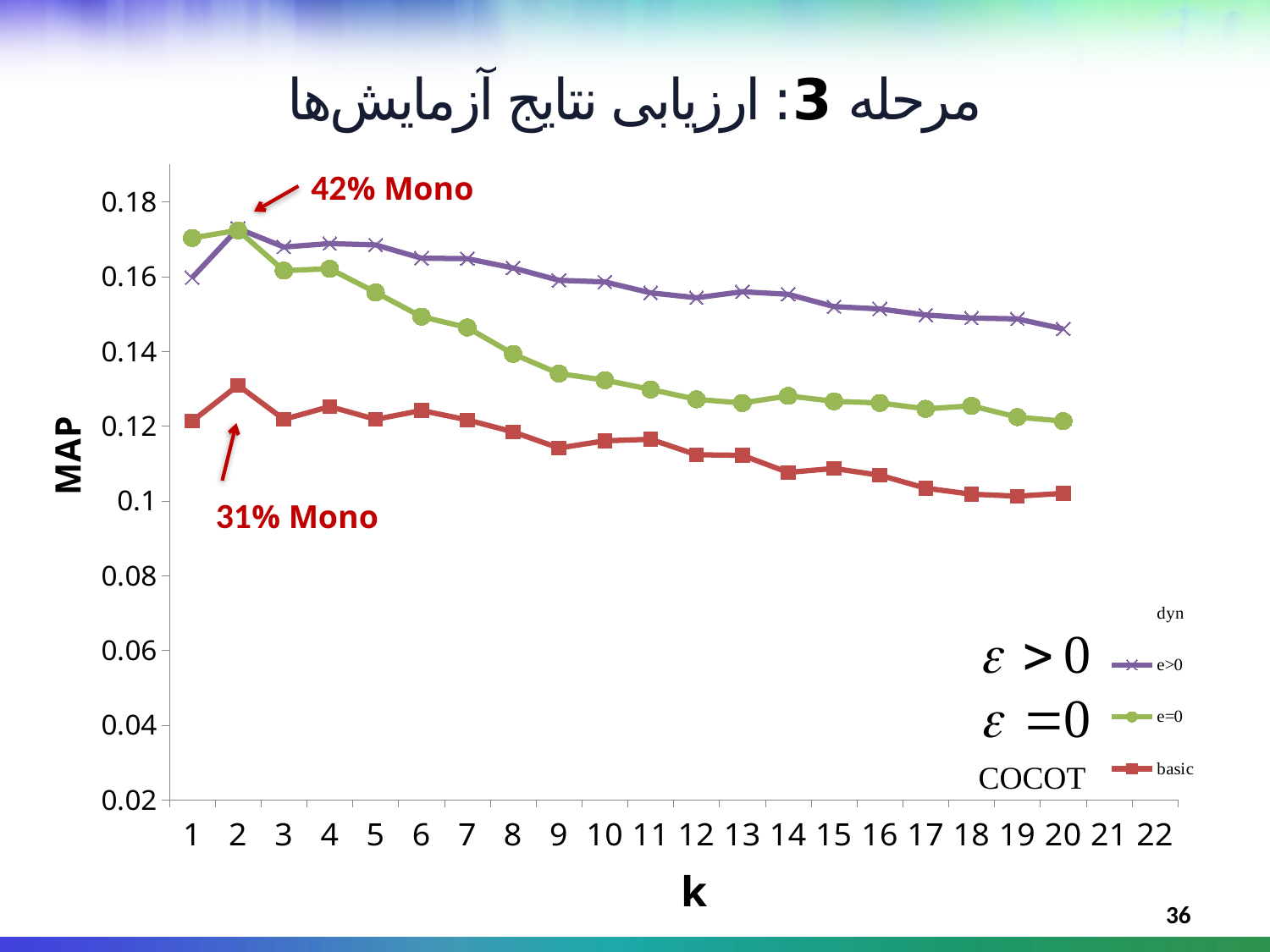
Is the value of the e>0 series at k=20 greater or less than 0.14? greater What annotation is attached to the peak of the e>0 series at k=2? 42% Mono Is the value of the e=0 series at k=1 greater or less than 0.16? greater Does the basic series generally rise or fall as k increases from 1 to 20? fall How many series does the legend list? 4 Is the value of the basic series at k=20 greater or less than 0.12? less What kind of chart is shown on the slide? line chart Does the e=0 series rise or fall as k increases from 2 to 20? fall Which series has the highest MAP value at k=15? e>0 At k=10, which series has the larger MAP value, e>0 or basic? e>0 Which series has the lowest MAP value at k=5? basic